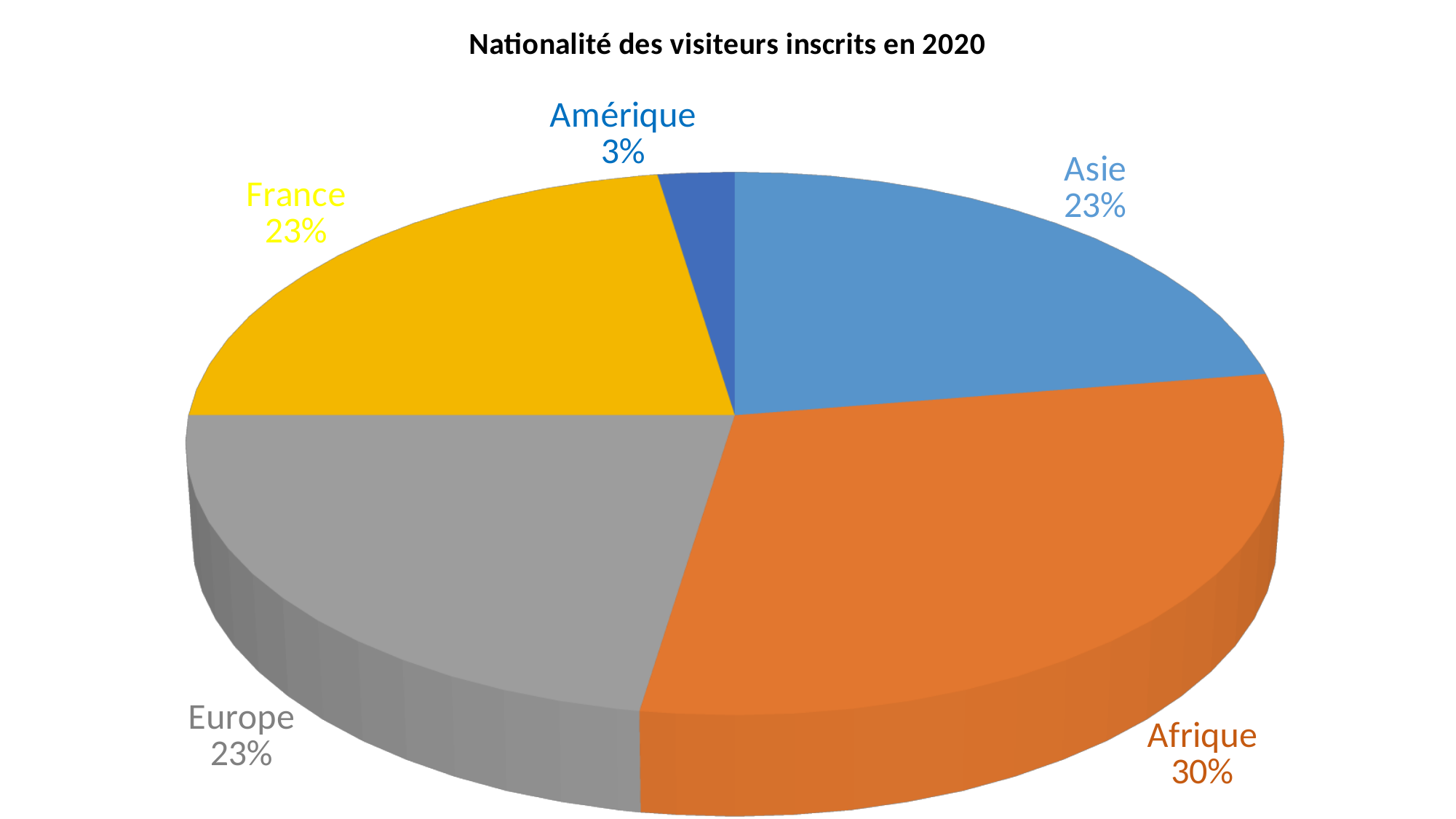
What colour is the slice for Europe? grey What is the difference in percentage points between Afrique and Amérique? 27 What share of the pie does Afrique represent? 30% What is the title of the chart? Nationalité des visiteurs inscrits en 2020 What is the value shown for Asie? 23% How many categories are shown in the pie chart? 5 What share of the pie does Amérique represent? 3% Which is larger, the share for Afrique or the share for France? Afrique What kind of chart is shown on the slide? pie chart Which category has the smallest share of the pie? Amérique What is the value shown for Europe? 23% Which category has the largest share of the pie? Afrique